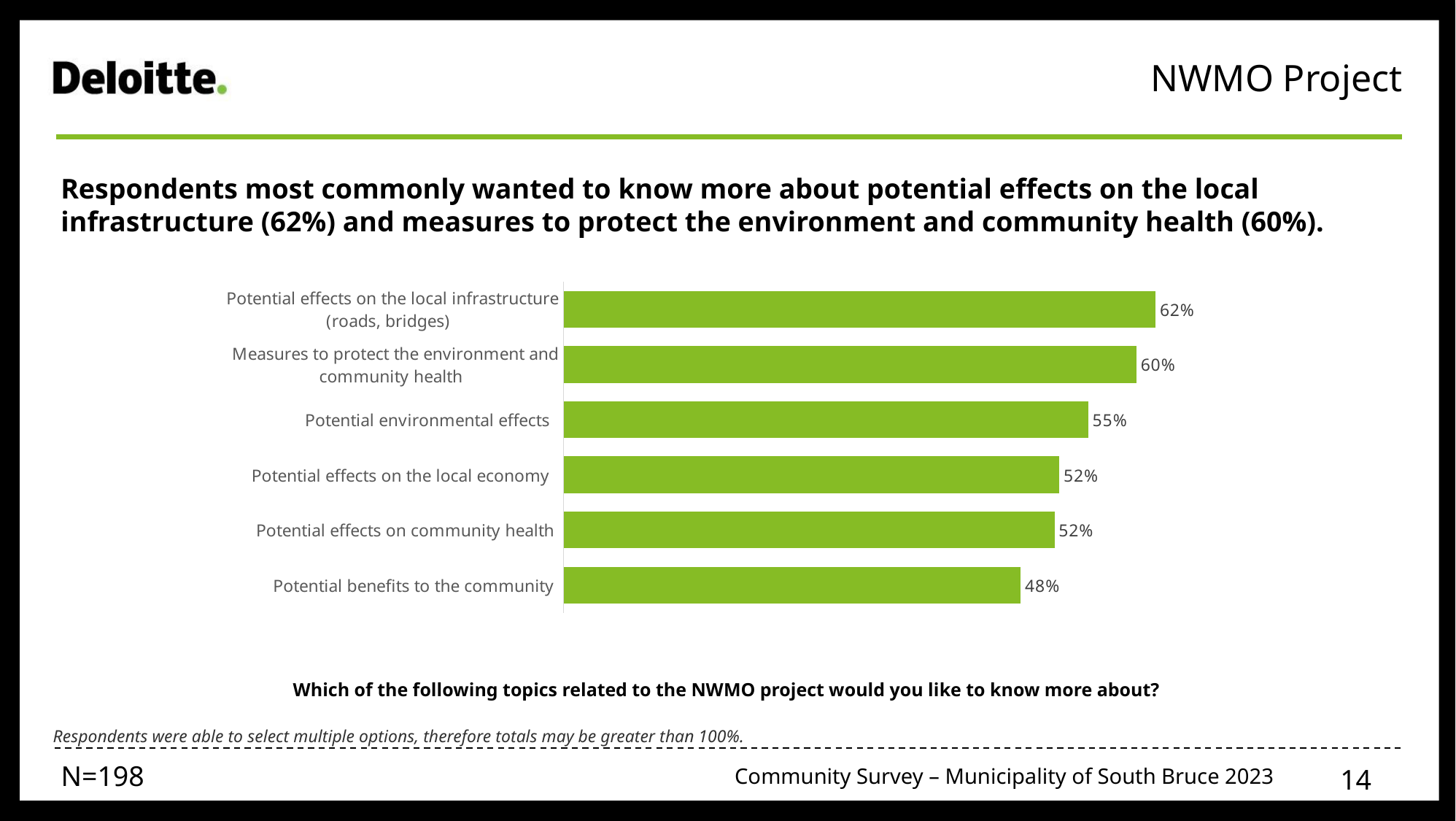
What percentage of respondents wanted to know more about measures to protect the environment and community health? 60% Which topic has the lowest percentage of respondents wanting to know more about it? Potential benefits to the community What percentage of respondents wanted to know more about potential environmental effects? 55% What kind of chart is shown on the slide? Bar chart What percentage of respondents wanted to know more about potential effects on the local infrastructure (roads, bridges)? 62% How many topics are shown in the chart? 6 What is the difference in percentage points between potential effects on the local infrastructure and potential benefits to the community? 14 Which topic has the highest percentage of respondents wanting to know more about it? Potential effects on the local infrastructure (roads, bridges) Which is larger: the value for potential environmental effects or the value for potential effects on community health? Potential environmental effects What is the difference in percentage points between potential environmental effects and potential effects on the local economy? 3 What is the sample size (N) shown on the slide? N=198 What percentage of respondents wanted to know more about potential benefits to the community? 48%